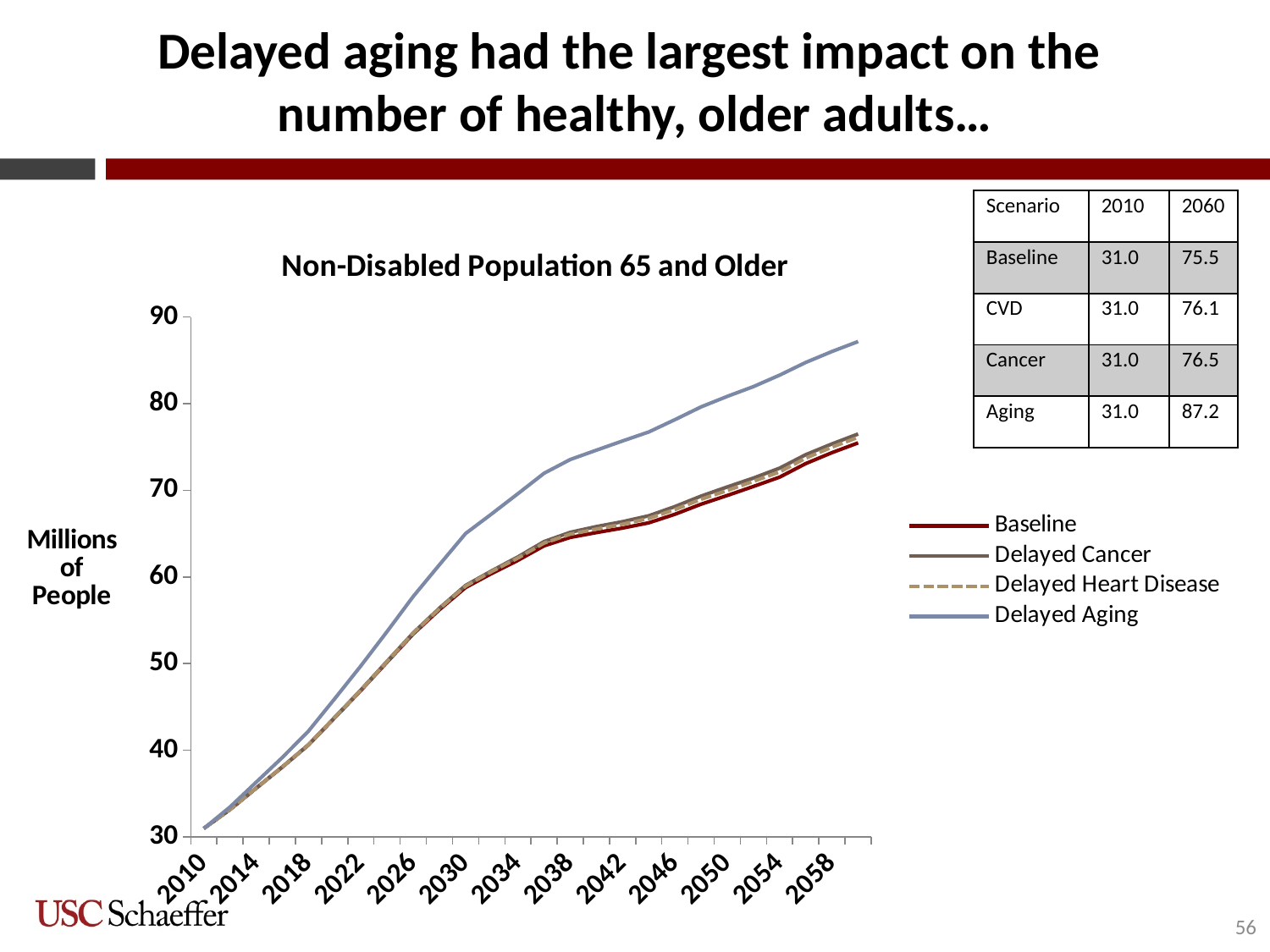
What kind of chart is shown on the slide? line chart What is the difference between the Aging and Baseline values in 2060 in the table? 11.7 How many series does the chart legend list? 4 Is the Delayed Aging value in 2030 greater or less than 60? greater Which series has the highest value in 2060? Delayed Aging Do the values of the Baseline series rise or fall from 2010 to 2060? rise What is the label on the vertical axis of the chart? Millions of People According to the table, what is the Aging scenario value in 2060? 87.2 According to the table, what is the value for every scenario in 2010? 31.0 According to the table, what is the Baseline value in 2060? 75.5 What is the title of the chart? Non-Disabled Population 65 and Older Which scenario has the lowest value in 2060 according to the table? Baseline